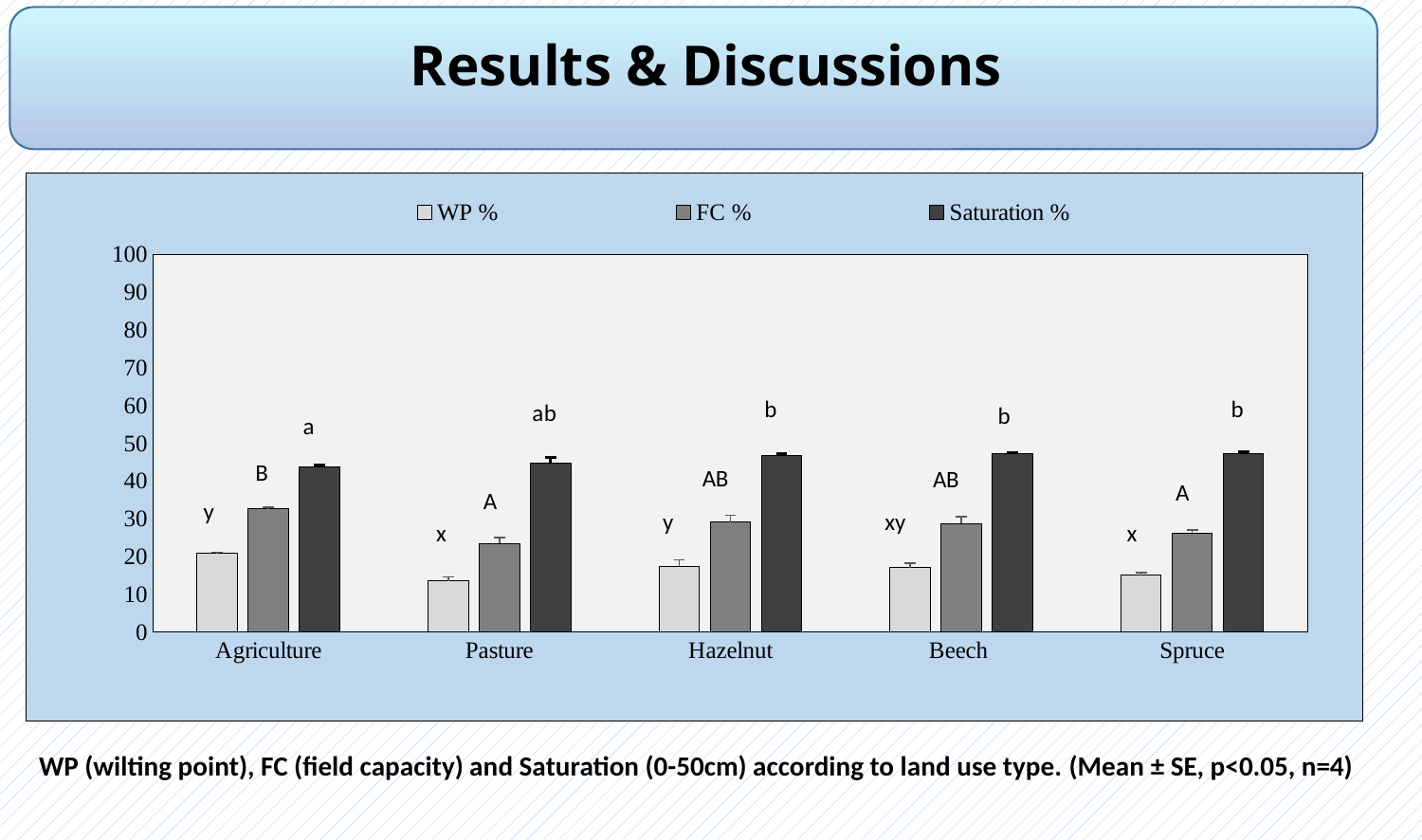
How many land use categories are shown on the x axis? 5 Is the Saturation % value for Hazelnut greater or less than 40? greater What kind of chart is shown on the slide? bar chart Which series are listed in the legend? WP %, FC %, Saturation % Is the Saturation % value for Agriculture greater or less than 50? less What letter label is printed above the Saturation % bar for Agriculture? a Which land use type has the highest FC % value? Agriculture Which is larger, the FC % value for Agriculture or the FC % value for Pasture? Agriculture Is the WP % value for Pasture greater or less than 20? less How many series does the legend list? 3 Which land use type has the highest WP % value? Agriculture